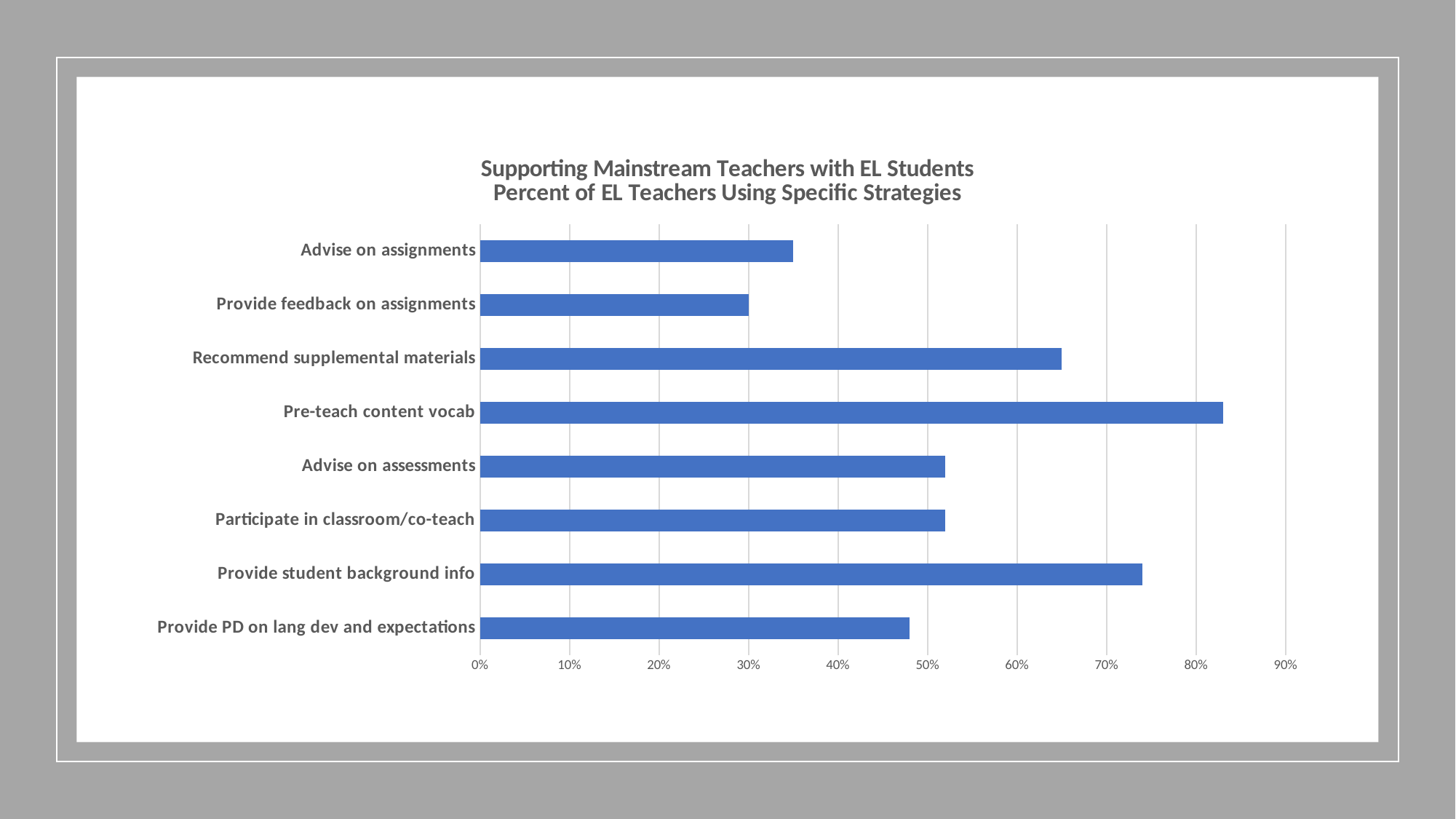
Is the value for Recommend supplemental materials greater or less than 60%? greater Which strategy has the highest percentage of EL teachers using it? Pre-teach content vocab Which is larger: the value for Recommend supplemental materials or the value for Advise on assignments? Recommend supplemental materials Which strategy has the lowest percentage of EL teachers using it? Provide feedback on assignments What kind of chart is shown on the slide? bar chart Which is larger: the value for Pre-teach content vocab or the value for Provide student background info? Pre-teach content vocab Is the value for Advise on assignments greater or less than 40%? less Is the value for Provide PD on lang dev and expectations greater or less than 50%? less How many strategies (categories) are plotted in the chart? 8 What is the first line of the chart's title? Supporting Mainstream Teachers with EL Students